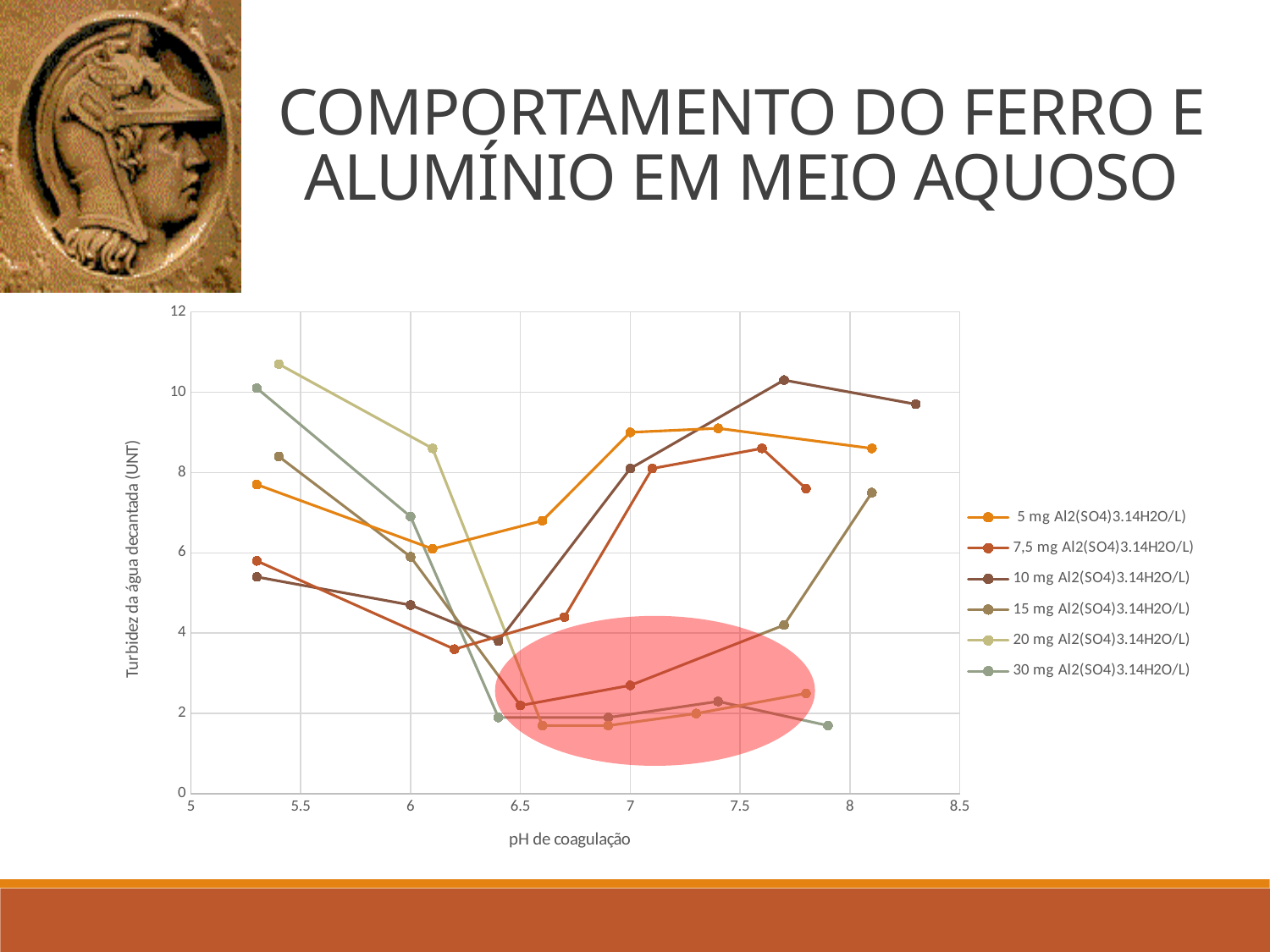
At pH 6.1, which series has the higher turbidity: 20 mg Al2(SO4)3.14H2O/L or 5 mg Al2(SO4)3.14H2O/L? 20 mg Al2(SO4)3.14H2O/L Is the highest value of the 10 mg Al2(SO4)3.14H2O/L series greater or less than 10? greater What is the label of the y axis of the chart? Turbidez da água decantada (UNT) Does the 5 mg Al2(SO4)3.14H2O/L series rise or fall between pH 6.1 and pH 7? rise Is the first (leftmost) value of the 20 mg Al2(SO4)3.14H2O/L series greater or less than 10? greater Which series reaches the highest turbidity value on the chart? 20 mg Al2(SO4)3.14H2O/L Does the 30 mg Al2(SO4)3.14H2O/L series rise or fall between pH 5.3 and pH 6.4? fall Is the first (leftmost) value of the 5 mg Al2(SO4)3.14H2O/L series greater or less than 8? less How many series does the chart legend list? 6 What is the label of the x axis of the chart? pH de coagulação What kind of chart is shown on the slide? Line chart